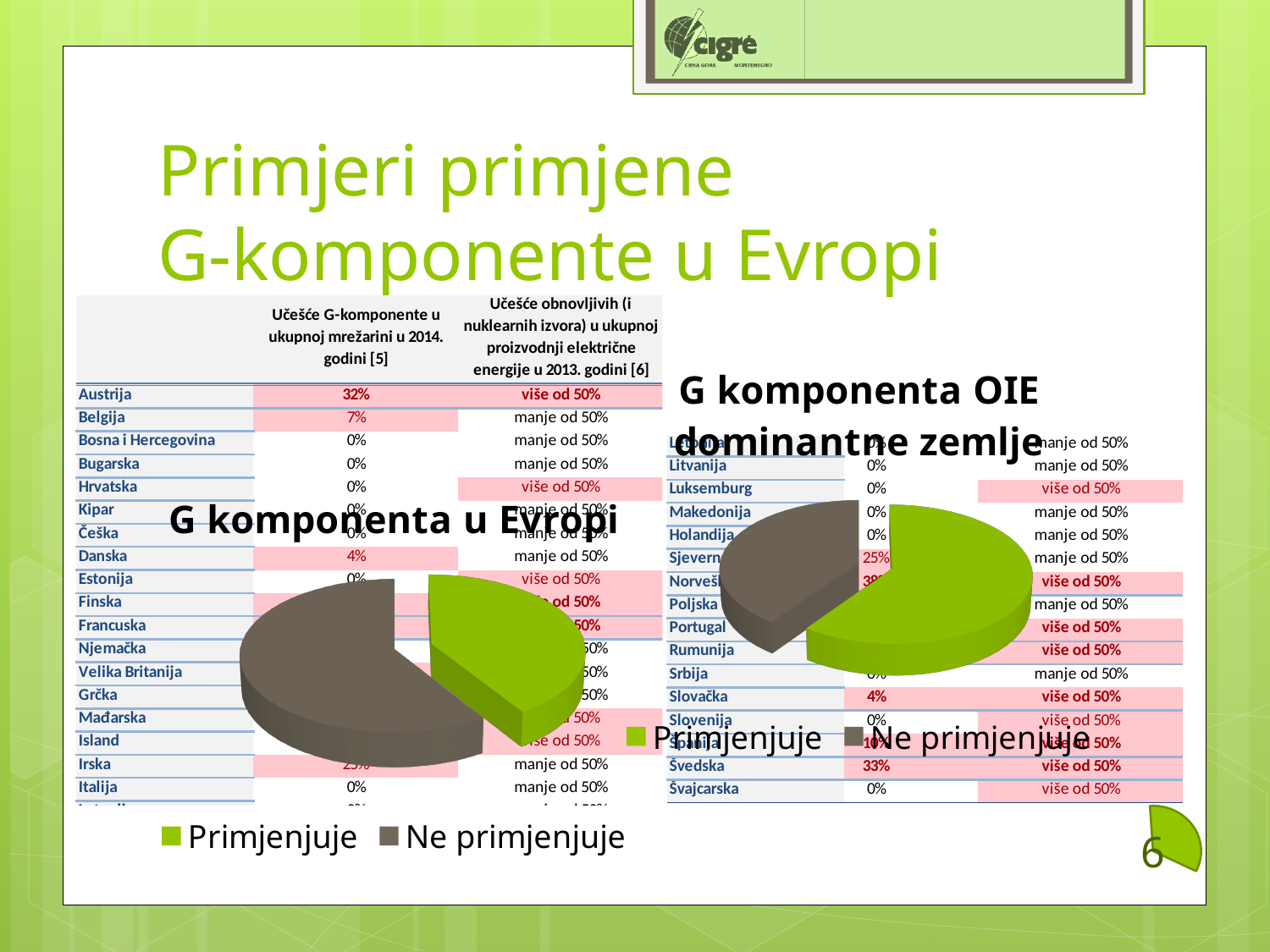
How many slices does the chart titled "G komponenta OIE dominantne zemlje" have? 2 How many entries does the legend of the chart titled "G komponenta u Evropi" list? 2 In the chart titled "G komponenta u Evropi", which slice is larger, "Primjenjuje" or "Ne primjenjuje"? Ne primjenjuje How many pie charts are shown on the slide? 2 What kind of chart is the chart titled "G komponenta u Evropi"? pie chart In the chart titled "G komponenta OIE dominantne zemlje", which category has the largest slice? Primjenjuje What kind of chart is the chart titled "G komponenta OIE dominantne zemlje"? pie chart In the chart titled "G komponenta OIE dominantne zemlje", which slice is larger, "Primjenjuje" or "Ne primjenjuje"? Primjenjuje In the chart titled "G komponenta u Evropi", which category has the smallest slice? Primjenjuje What colour represents "Primjenjuje" in the legend of the chart titled "G komponenta u Evropi"? green What is the title of the pie chart on the right side of the slide? G komponenta OIE dominantne zemlje